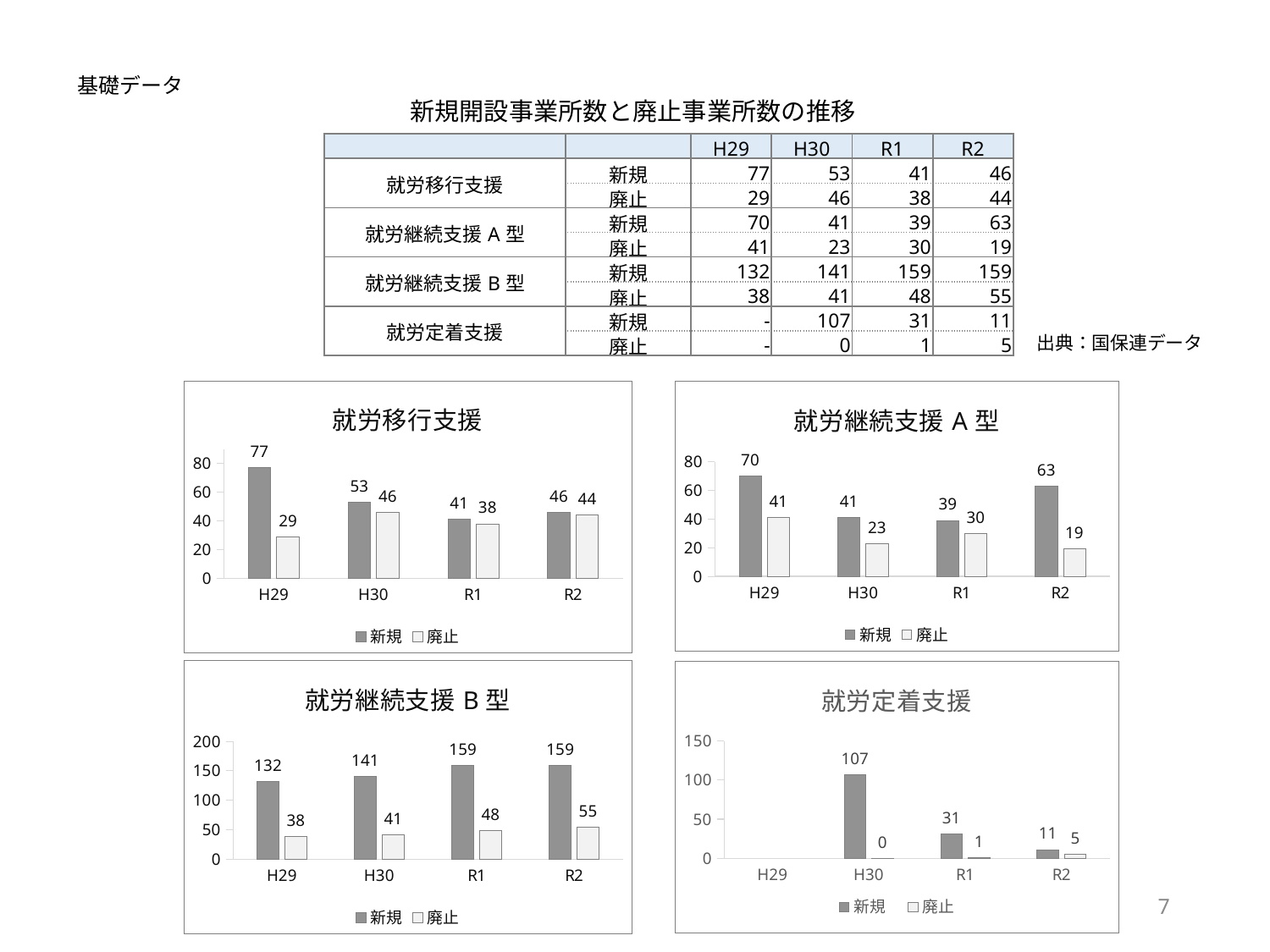
In the 就労継続支援 B 型 chart, how many years are shown on the x axis? 4 What type of chart is the 就労継続支援 B 型 chart? bar chart In the 就労継続支援 B 型 chart, does the 廃止 value rise or fall from H29 to R2? rise In the 就労移行支援 chart, what is the value of 新規 for H29? 77 What are the two legend entries in the 就労移行支援 chart? 新規 and 廃止 In the 就労継続支援 B 型 chart, which year has the lowest 新規 value? H29 In the 就労定着支援 chart, which year has the highest 新規 value? H30 In the 就労定着支援 chart, what is the value of 廃止 for R1? 1 In the 就労継続支援 A 型 chart, what is the value of 廃止 for R2? 19 In the 就労移行支援 chart, what is the difference between 新規 and 廃止 for H29? 48 In the 就労継続支援 A 型 chart, is 新規 or 廃止 larger for R2? 新規 In the 就労定着支援 chart, how many series does the legend list? 2